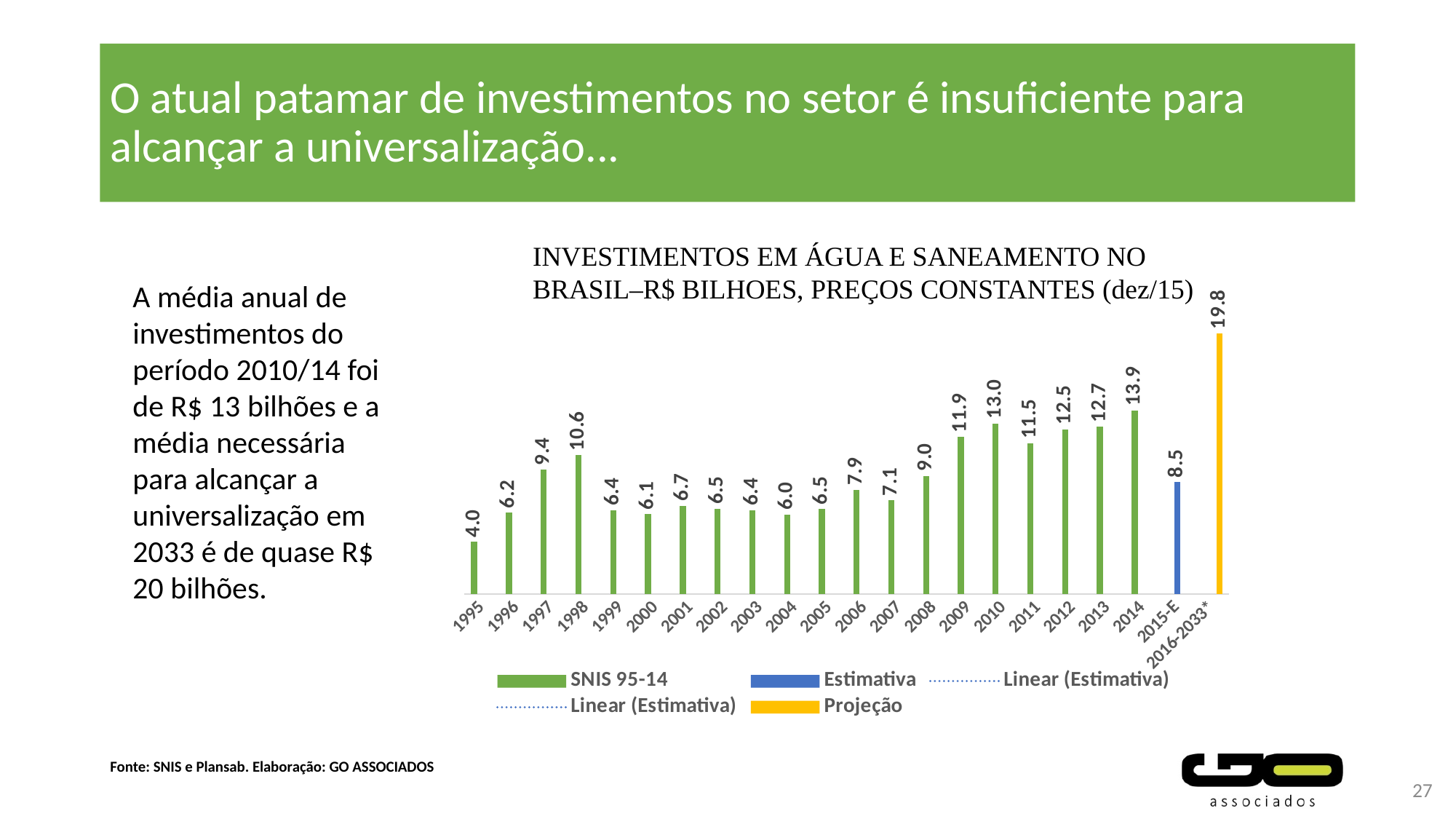
Do the values generally rise or fall from 2004 to 2010? Rise Which category has the highest value in the chart? 2016-2033* What is the value shown for the 2016-2033* bar? 19.8 What is the difference between the values for 2014 and 2015-E? 5.4 Which is larger, the value for 2010 or the value for 2011? 2010 What kind of chart is shown on the slide? Bar chart How many bars are plotted in the chart? 22 What is the value shown for 1998? 10.6 How many entries does the legend list? 5 What colour is the bar for 2016-2033*? Yellow Which year has the lowest value in the chart? 1995 What is the value shown for 2015-E? 8.5